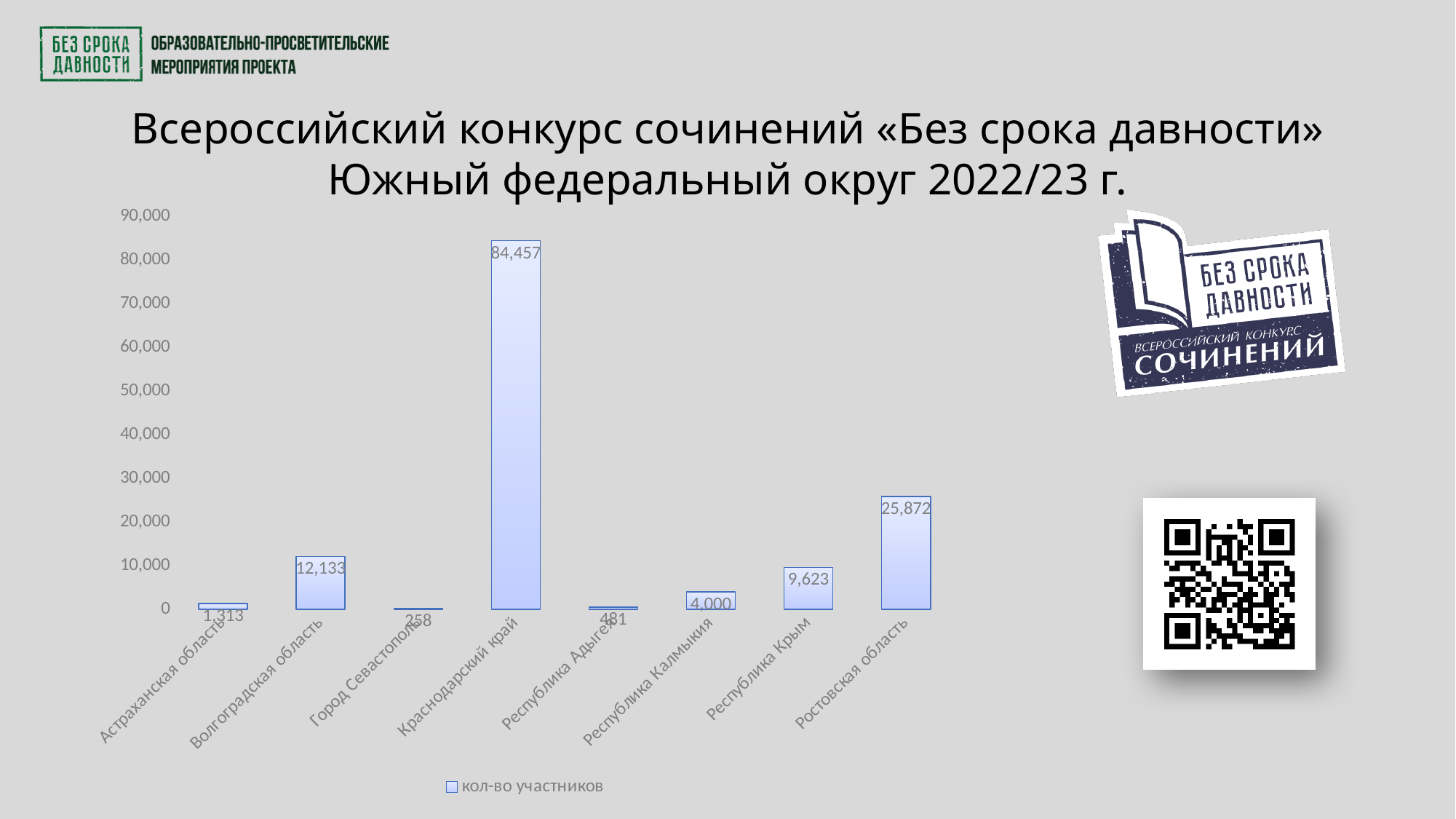
What is the value for Республика Калмыкия? 4,000 How many regions (categories) are shown on the x axis of the chart? 8 What is the value for Краснодарский край? 84,457 What is the legend entry of the chart? кол-во участников How many series does the chart legend list? 1 Which region has the lowest number of participants? Город Севастополь What type of chart is shown on the slide? bar chart What is the value for Ростовская область? 25,872 Which is larger, the value for Республика Крым or the value for Республика Калмыкия? Республика Крым What is the difference between the values for Ростовская область and Волгоградская область? 13,739 What is the value for Волгоградская область? 12,133 Which region has the highest number of participants? Краснодарский край